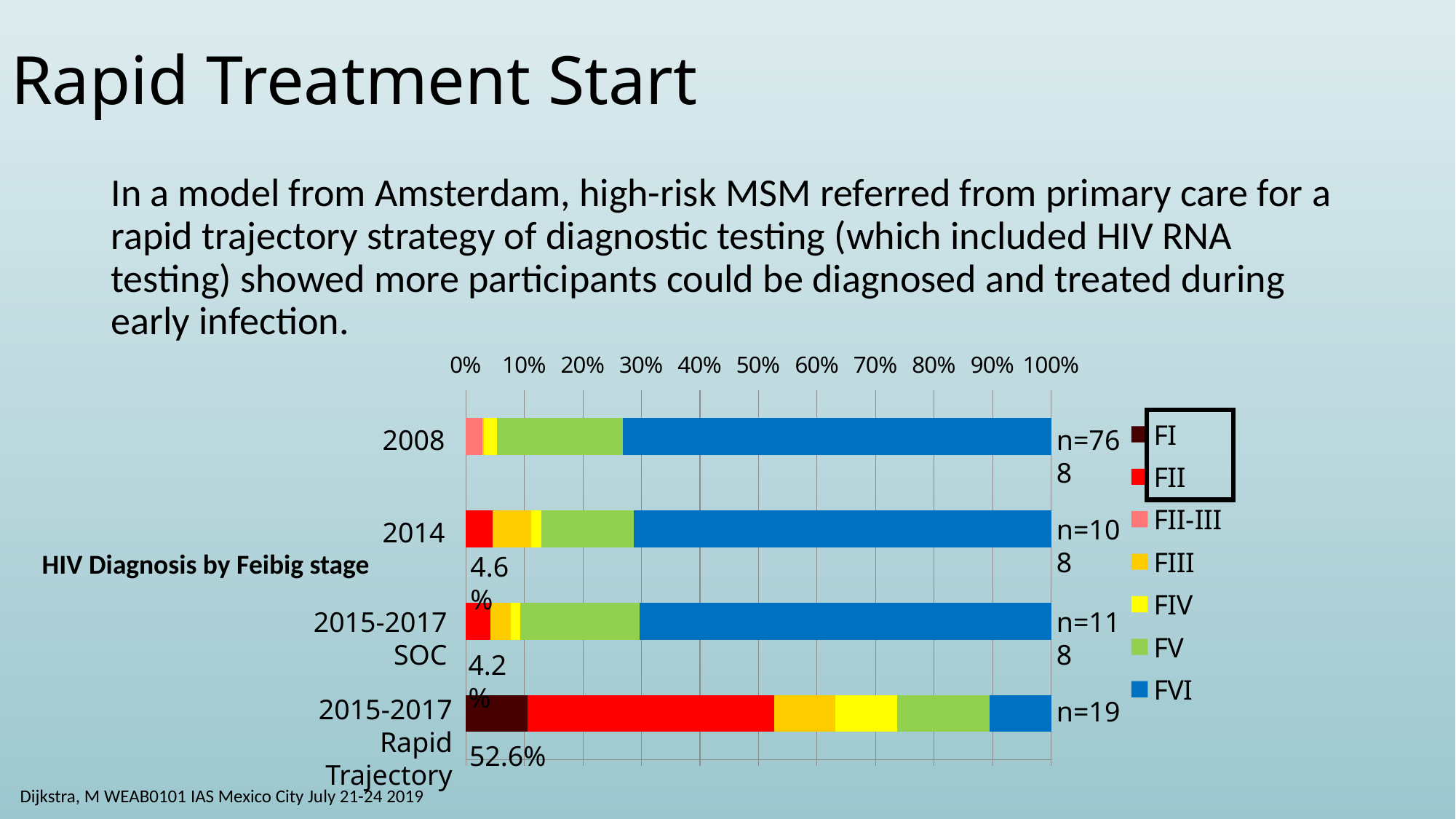
Which bar has the largest FII segment? 2015-2017 Rapid Trajectory What is the title of the chart? HIV Diagnosis by Feibig stage What percentage label is printed below the 2014 bar? 4.6% Is the FVI share of the 2015-2017 Rapid Trajectory bar greater or less than 20%? less How many series does the chart legend list? 7 What kind of chart is shown on the slide? Stacked bar chart Is the FVI share of the 2008 bar greater or less than 50%? greater How many categories (bars) does the chart show? 4 What percentage label is printed below the 2015-2017 Rapid Trajectory bar? 52.6% What is the n value shown next to the 2015-2017 Rapid Trajectory bar? n=19 What is the n value shown next to the 2008 bar? n=768 What percentage label is printed below the 2015-2017 SOC bar? 4.2%